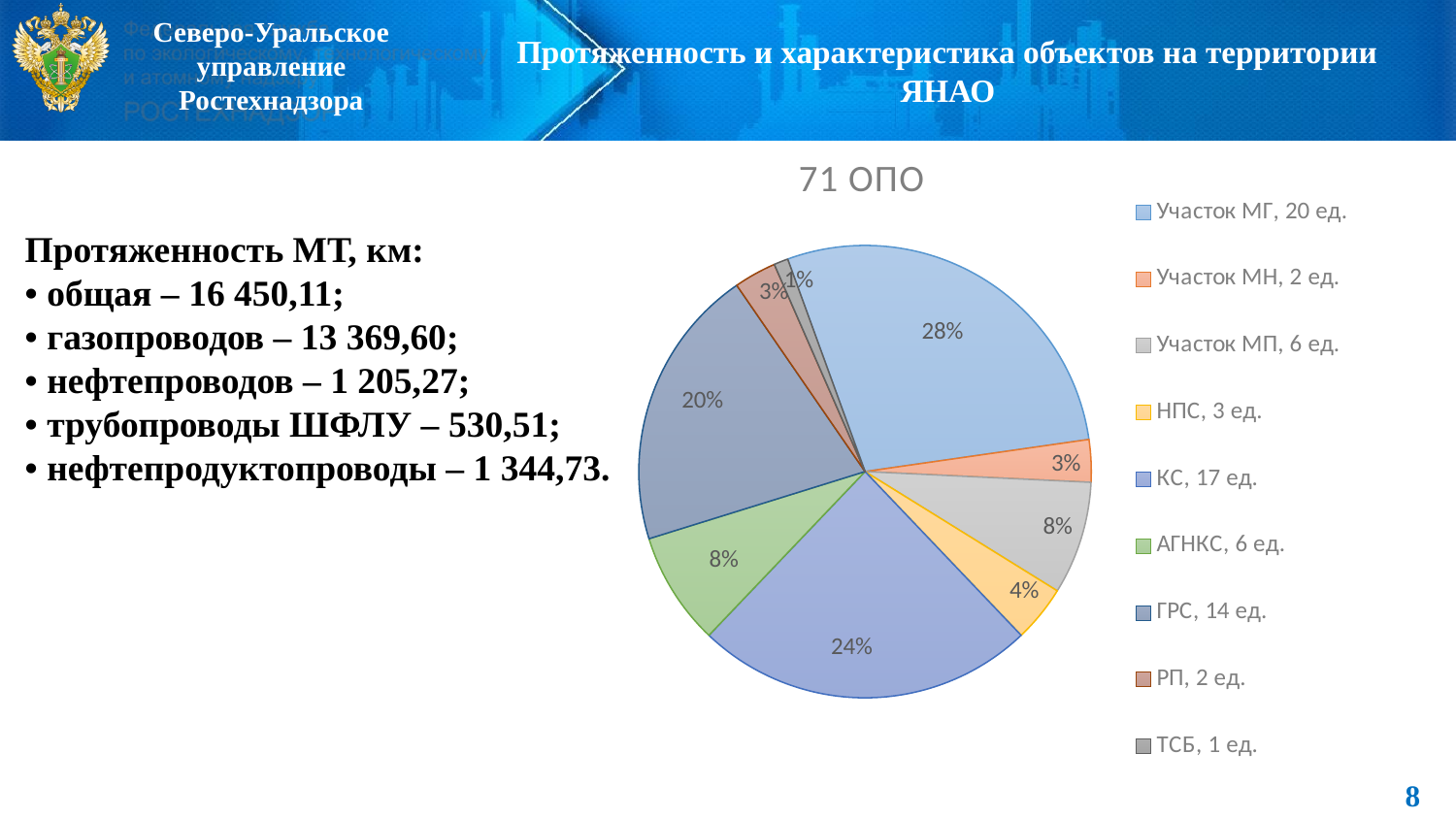
What share of the pie does Участок МГ represent? 28% Which category has the smallest slice of the pie chart? ТСБ How many units does the legend give for КС? 17 ед. What is the title of the pie chart? 71 ОПО What is the difference in units between Участок МГ and КС? 3 Which category has the largest slice of the pie chart? Участок МГ Which has more units, Участок МГ or ГРС? Участок МГ What share of the pie does КС represent? 24% What share of the pie does НПС represent? 4% What kind of chart is shown on the slide? pie chart How many categories does the pie chart legend list? 9 How many units does the legend give for ГРС? 14 ед.